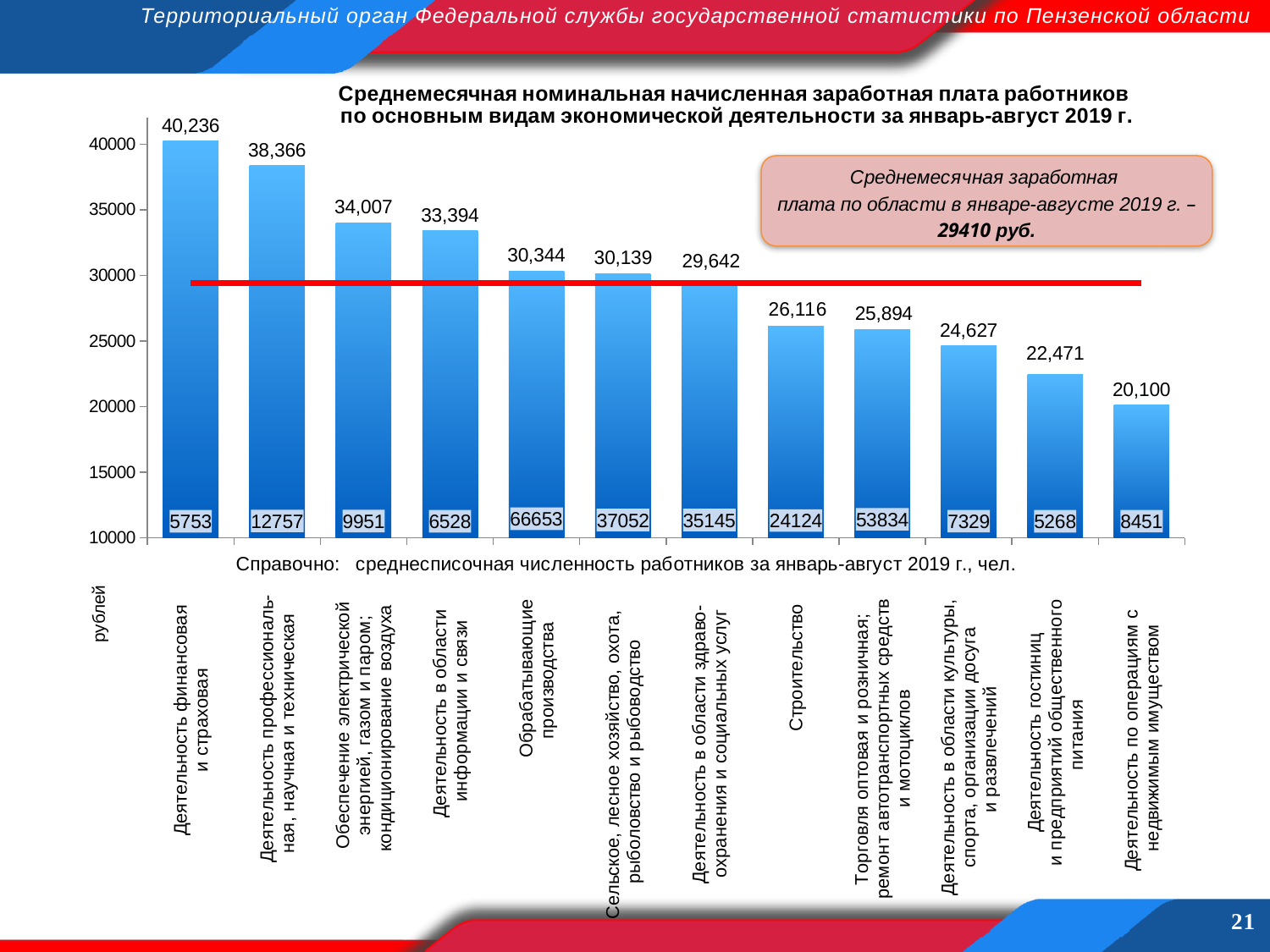
Which type of economic activity has the highest average monthly wage? Деятельность финансовая и страховая What kind of chart is shown on the slide? bar chart Is the average monthly wage for Деятельность в области информации и связи greater or less than 30000? greater What is the average number of employees (среднесписочная численность) shown for Обрабатывающие производства? 66653 How many types of economic activity are shown in the chart? 12 Which has a higher average monthly wage: Строительство or Деятельность в области культуры, спорта, организации досуга и развлечений? Строительство What is the average monthly wage shown for Обрабатывающие производства? 30,344 What regional average monthly wage for January-August 2019 is stated in the callout box? 29410 руб. Which type of economic activity has the lowest average monthly wage? Деятельность по операциям с недвижимым имуществом What is the difference between the average monthly wage for Деятельность финансовая и страховая and for Деятельность по операциям с недвижимым имуществом? 20,136 What is the average monthly wage shown for Строительство? 26,116 What is the average monthly wage shown for Деятельность гостиниц и предприятий общественного питания? 22,471